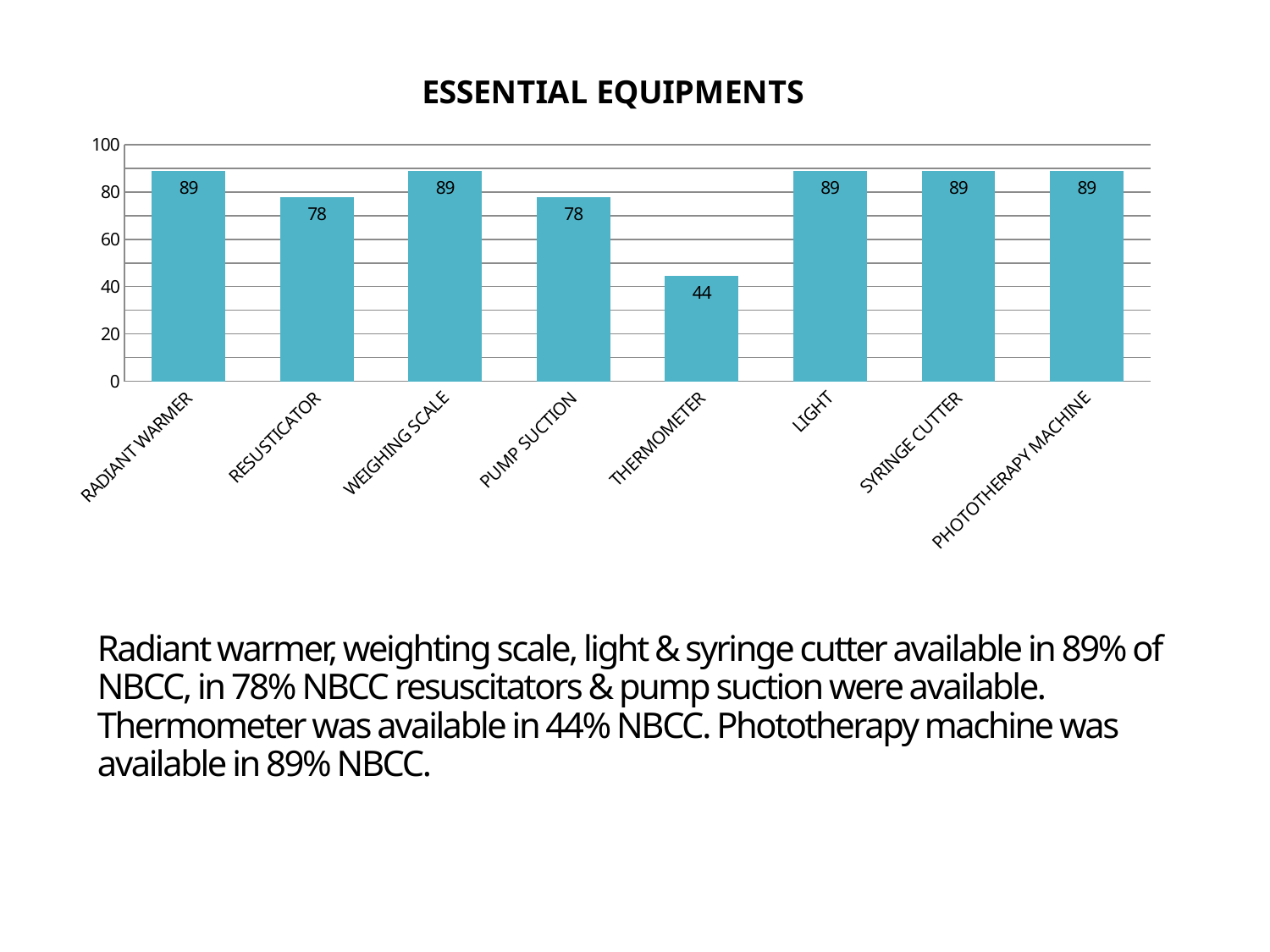
What is the value for THERMOMETER? 44 Is the value for THERMOMETER greater or less than 60? less What kind of chart is shown on the slide? bar chart Which category has the lowest value? THERMOMETER What is the difference between the values for LIGHT and PUMP SUCTION? 11 What is the value for PHOTOTHERAPY MACHINE? 89 How many categories are shown on the x axis? 8 Which is larger, the value for WEIGHING SCALE or the value for RESUSTICATOR? WEIGHING SCALE What is the value for RESUSTICATOR? 78 What is the title of the chart? ESSENTIAL EQUIPMENTS What is the value for PUMP SUCTION? 78 What is the difference between the values for RADIANT WARMER and THERMOMETER? 45